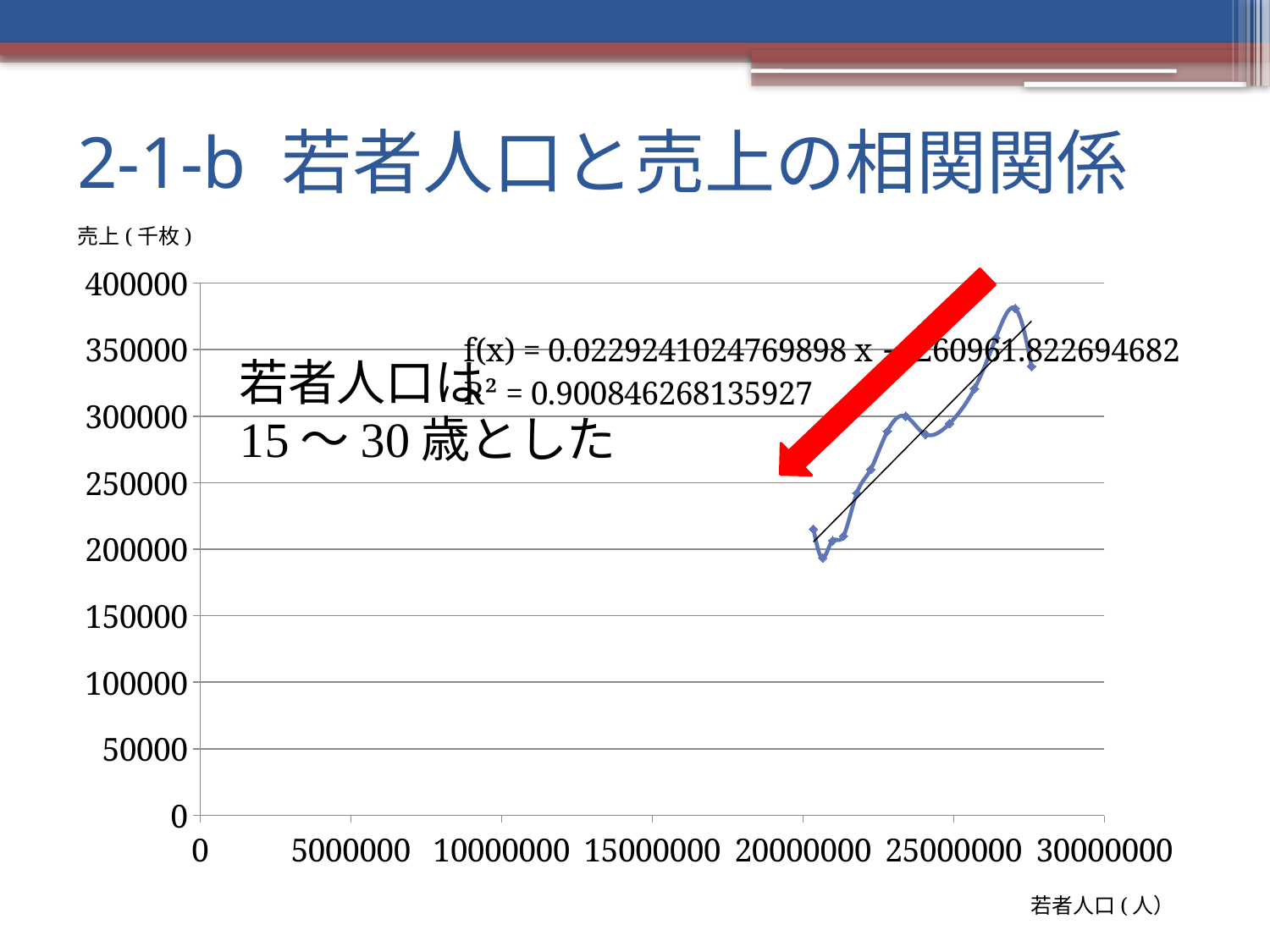
Is the highest plotted sales value greater or less than 400000? less Are the plotted youth population values greater or less than 30000000? less What kind of chart is shown on the slide? scatter chart with a trendline Are the plotted youth population values greater or less than 15000000? greater What is the R² value printed on the chart? 0.900846268135927 What is the maximum value shown on the y axis? 400000 What is the label of the x axis? 若者人口(人) Do the sales values generally rise or fall as the youth population increases along the x axis? rise